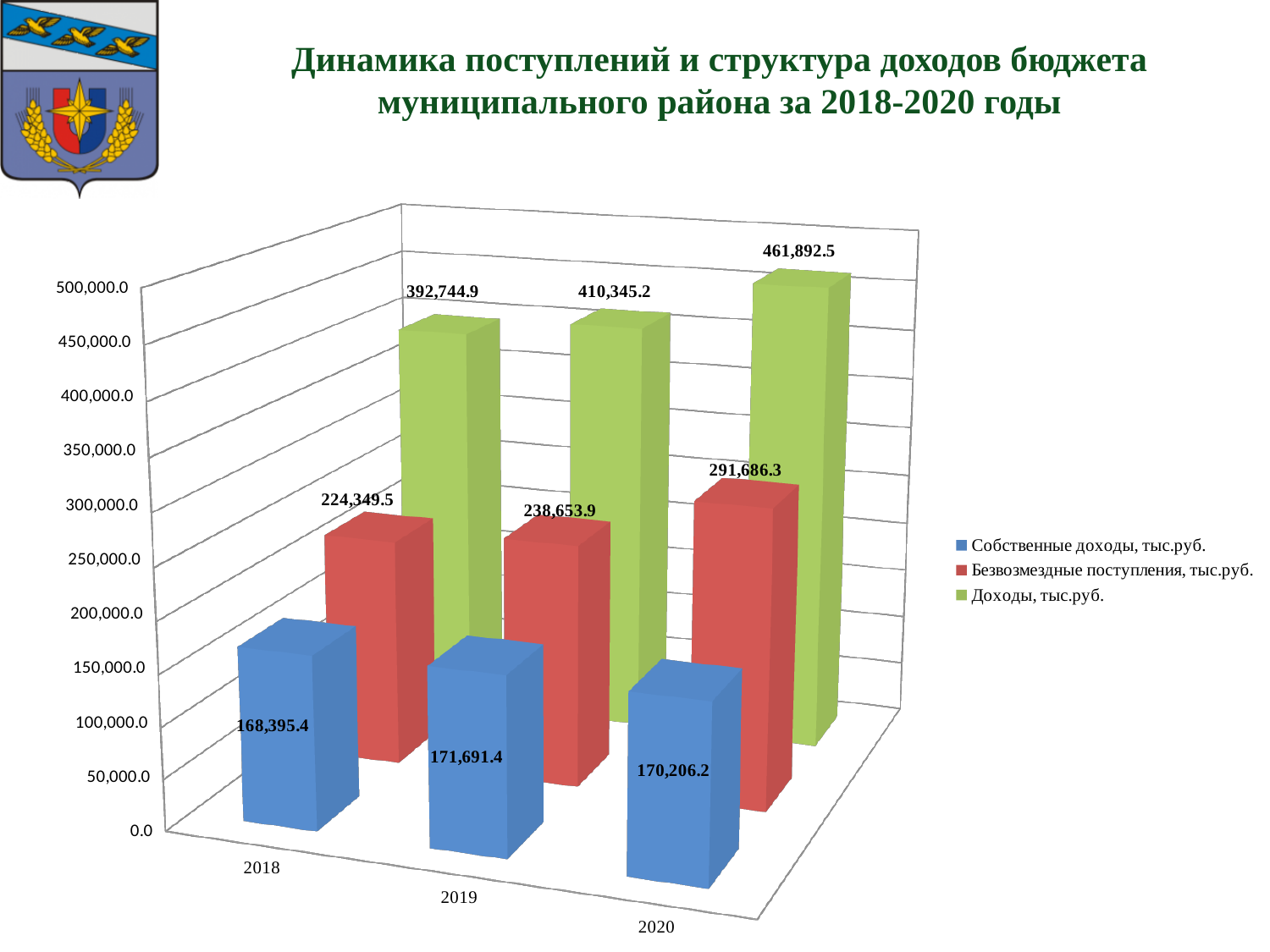
What kind of chart is shown on the slide? Bar chart Which is larger: Собственные доходы, тыс.руб. in 2019 or in 2020? 2019 How many years are shown on the x axis? 3 What is the value of Доходы, тыс.руб. for 2020? 461,892.5 How many series does the legend list? 3 Do the values of Безвозмездные поступления, тыс.руб. rise or fall from 2018 to 2020? Rise In which year is Доходы, тыс.руб. the highest? 2020 In which year is Собственные доходы, тыс.руб. the lowest? 2018 What is the value of Безвозмездные поступления, тыс.руб. for 2019? 238,653.9 What is the difference between Доходы, тыс.руб. in 2020 and in 2019? 51,547.3 What is the difference between Безвозмездные поступления, тыс.руб. in 2020 and in 2018? 67,336.8 What is the value of Собственные доходы, тыс.руб. for 2018? 168,395.4